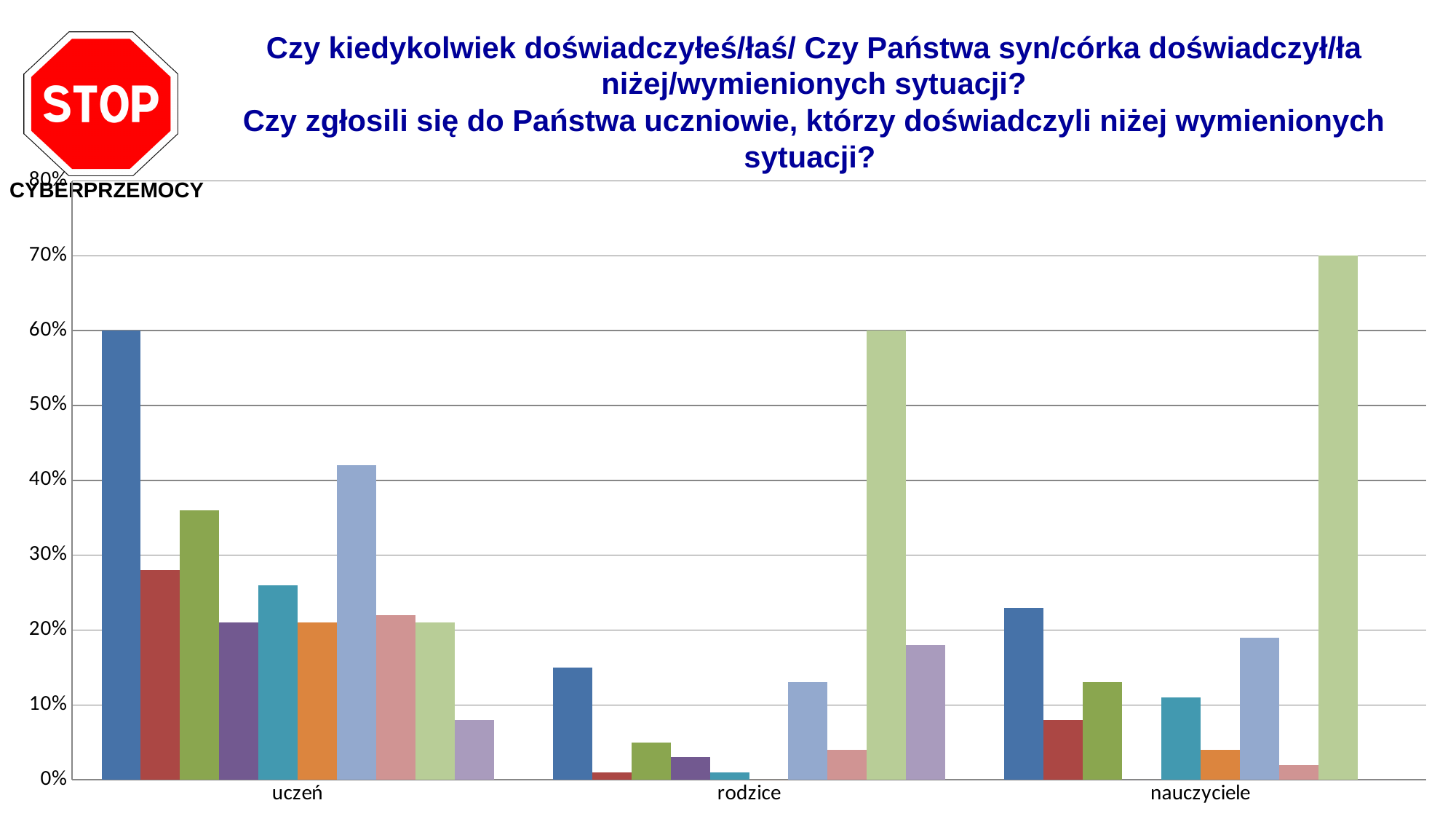
What is the value of the dark blue bar for uczeń? 60% Is the value of the light blue bar for uczeń greater or less than 40%? greater What kind of chart is shown on the slide? bar chart What is the value of the light green bar for nauczyciele? 70% Is the value of the dark blue bar for rodzice greater or less than 20%? less What are the three categories on the x axis of the chart? uczeń, rodzice, nauczyciele Is the light green bar for nauczyciele larger or smaller than the light green bar for rodzice? larger Which category has the tallest bar overall in the chart? nauczyciele What is the highest value shown on the vertical axis of the chart? 80% What is the difference between the light green bar for nauczyciele and the light green bar for rodzice? 10% What is the value of the light green bar for rodzice? 60% How many categories are shown on the x axis of the chart? 3